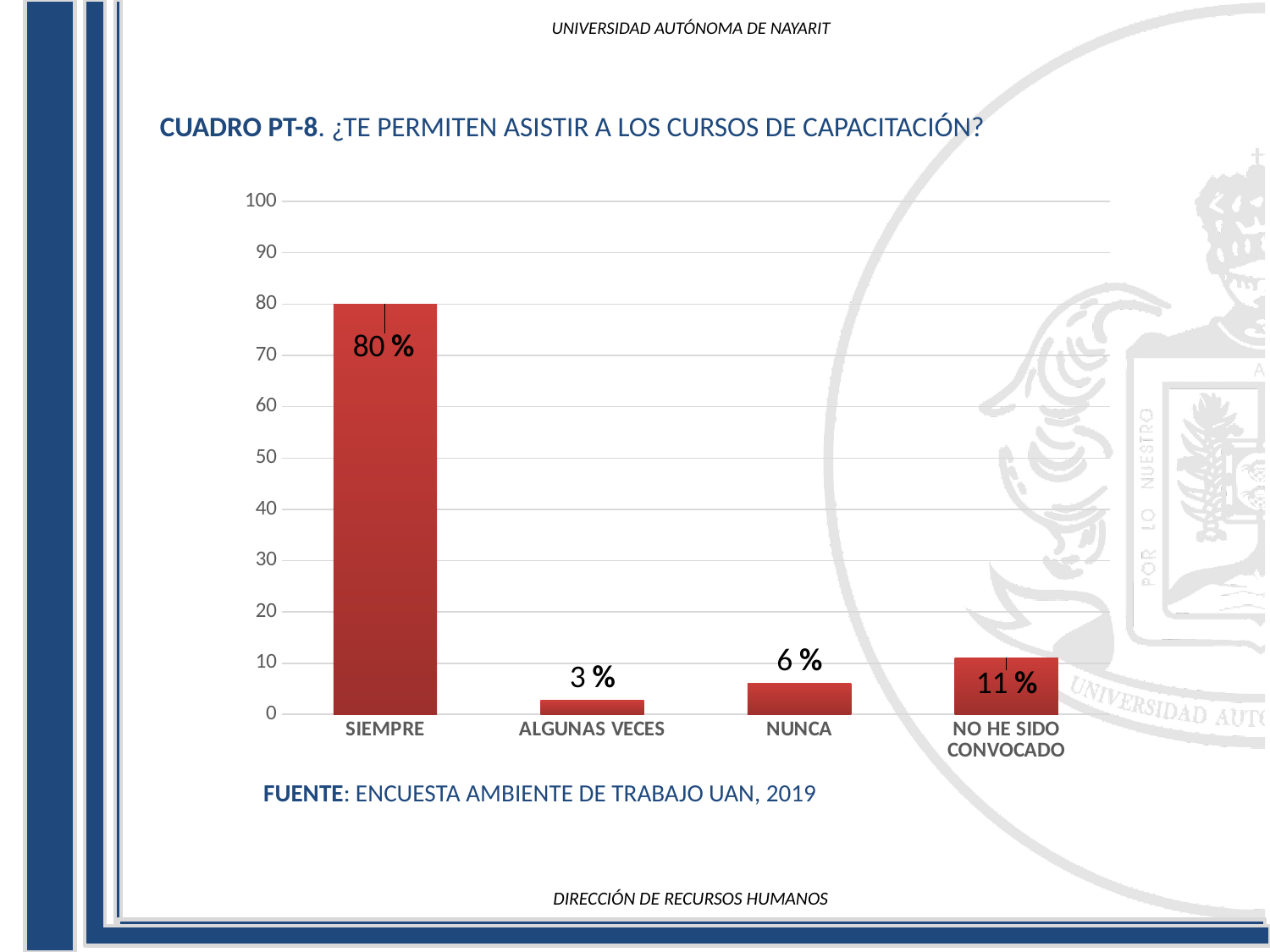
What is the value for NUNCA? 6 % Which category has the highest value? SIEMPRE What is the value for SIEMPRE? 80 % What is the difference between the values for NUNCA and ALGUNAS VECES? 3 % Which category has the lowest value? ALGUNAS VECES What kind of chart is shown on the slide? Bar chart What is the difference between the values for SIEMPRE and NO HE SIDO CONVOCADO? 69 % How many categories are shown on the x axis? 4 What source is cited below the chart? ENCUESTA AMBIENTE DE TRABAJO UAN, 2019 Which is larger, the value for NUNCA or the value for NO HE SIDO CONVOCADO? NO HE SIDO CONVOCADO What is the value for ALGUNAS VECES? 3 % What is the value for NO HE SIDO CONVOCADO? 11 %